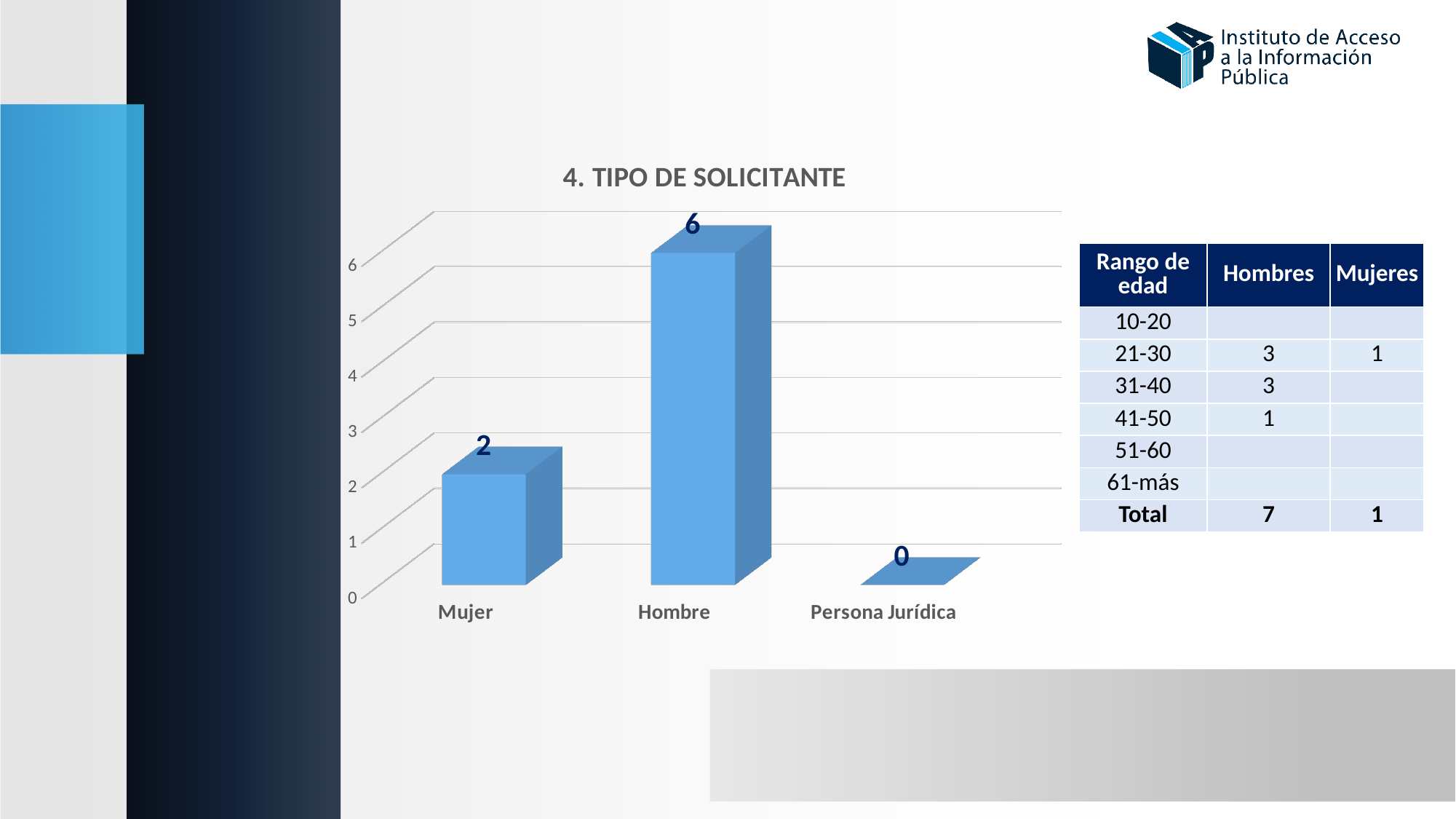
What is the highest value shown on the vertical axis of the chart? 6 What is the value for Persona Jurídica in the chart? 0 Which category has the highest value in the chart? Hombre Is the value for Hombre greater or less than 5? greater How many categories are shown on the x axis of the chart? 3 Which is larger, the value for Mujer or the value for Hombre? Hombre What is the value for Hombre in the chart? 6 What is the value for Mujer in the chart? 2 What is the difference between the values for Hombre and Mujer? 4 Which category has the lowest value in the chart? Persona Jurídica What is the title of the chart? 4. TIPO DE SOLICITANTE What kind of chart is shown on the slide? bar chart